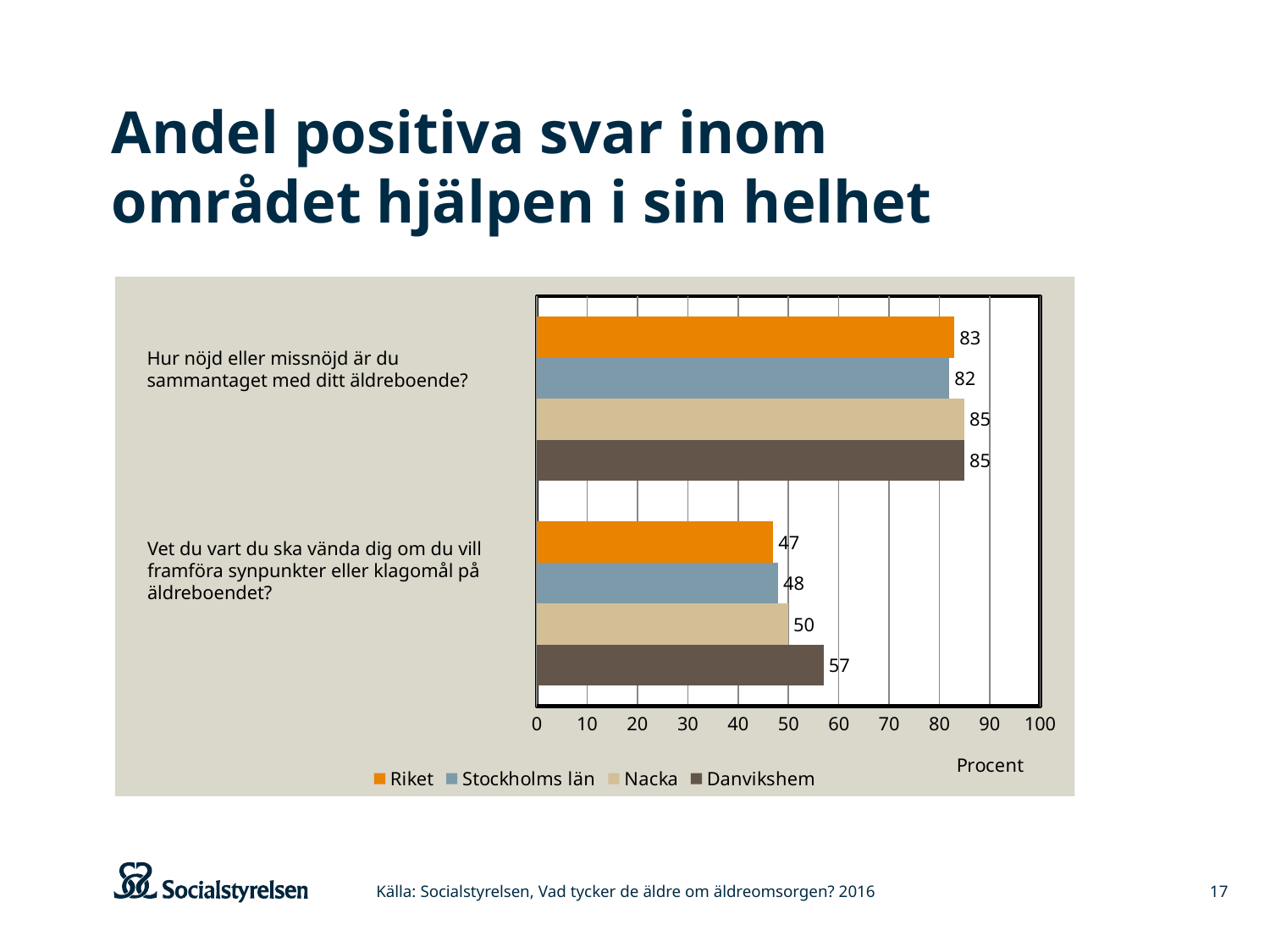
Is the value for Nacka on the question "Vet du vart du ska vända dig om du vill framföra synpunkter eller klagomål på äldreboendet?" greater or less than 60? less What is the value for Nacka on the question "Hur nöjd eller missnöjd är du sammantaget med ditt äldreboende?"? 85 How many series does the legend list? 4 What kind of chart is shown on the slide? Bar chart What is the value for Stockholms län on the question "Vet du vart du ska vända dig om du vill framföra synpunkter eller klagomål på äldreboendet?"? 48 What is the difference between the Danvikshem and Riket values on the question "Vet du vart du ska vända dig om du vill framföra synpunkter eller klagomål på äldreboendet?"? 10 Which series has the highest value on the question "Vet du vart du ska vända dig om du vill framföra synpunkter eller klagomål på äldreboendet?"? Danvikshem Which is larger on the question "Hur nöjd eller missnöjd är du sammantaget med ditt äldreboende?": the value for Riket or the value for Stockholms län? Riket What is the value for Danvikshem on the question "Vet du vart du ska vända dig om du vill framföra synpunkter eller klagomål på äldreboendet?"? 57 What is the value for Riket on the question "Hur nöjd eller missnöjd är du sammantaget med ditt äldreboende?"? 83 What unit label is shown on the horizontal axis of the chart? Procent Which series has the lowest value on the question "Vet du vart du ska vända dig om du vill framföra synpunkter eller klagomål på äldreboendet?"? Riket